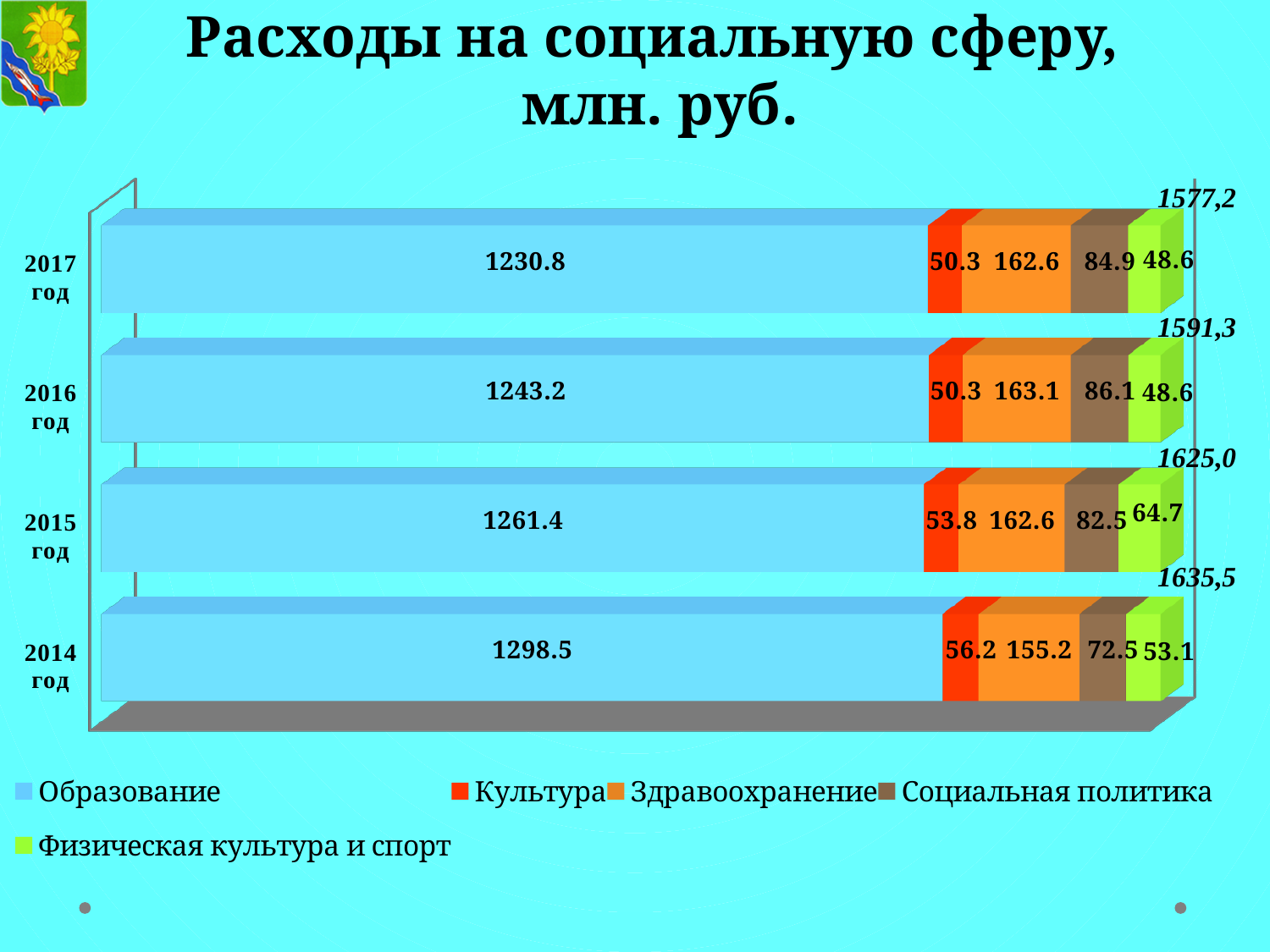
How many years are shown on the chart? 4 What is the value for Физическая культура и спорт in 2015 год? 64.7 What is the value for Культура in 2014 год? 56.2 What kind of chart is shown on the slide? Stacked bar chart What is the value for Здравоохранение in 2015 год? 162.6 Which is larger: Социальная политика in 2015 год or in 2017 год? 2017 год In which year is the value for Социальная политика the lowest? 2014 год What is the difference between the Образование values for 2014 год and 2017 год? 67.7 What is the total of the stacked bar for 2017 год? 1577,2 How many series does the legend list? 5 In which year is the value for Образование the highest? 2014 год What is the value for Образование in 2017 год? 1230.8